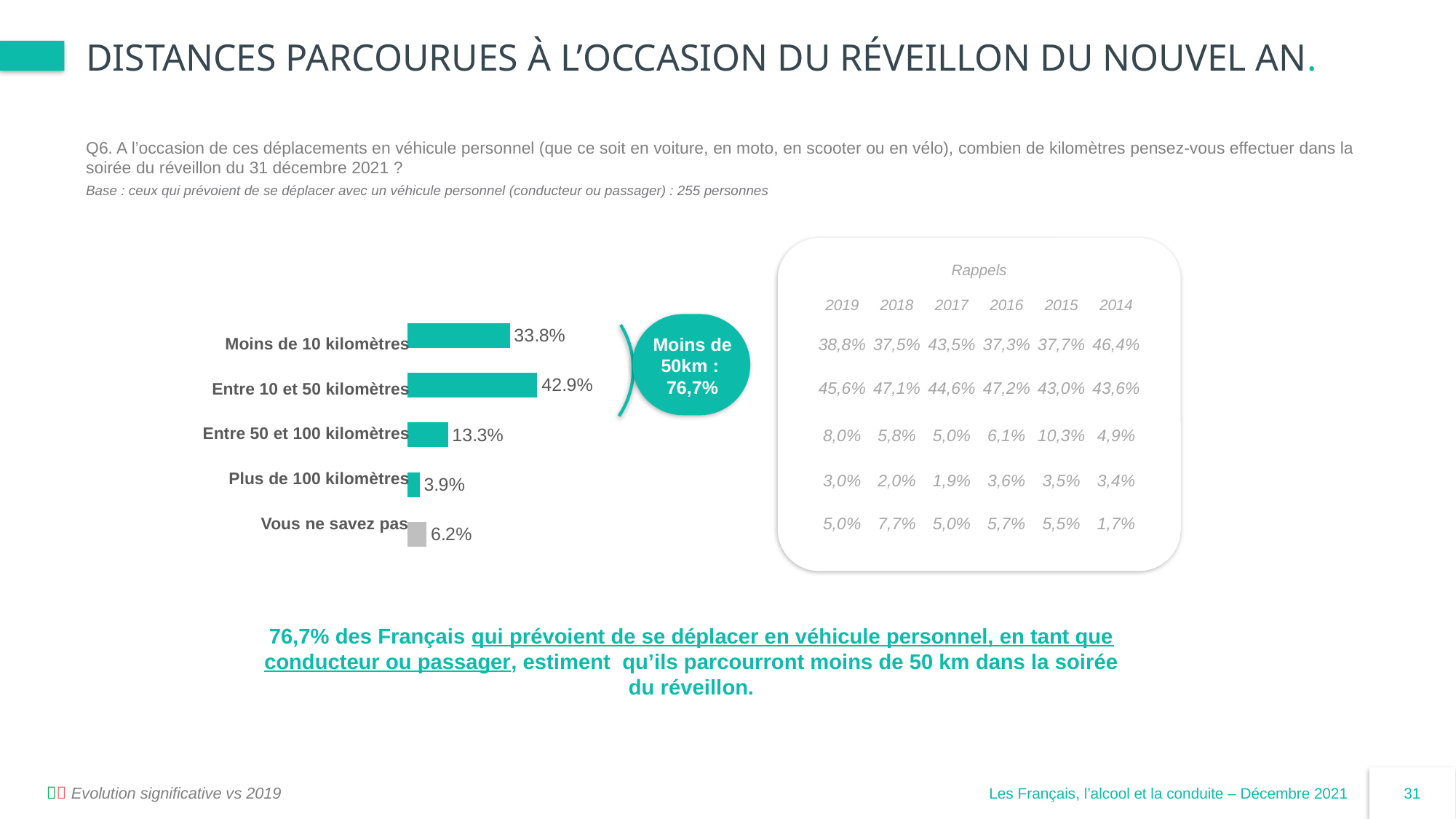
Which category has the highest value? Entre 10 et 50 kilomètres How many categories are shown in the bar chart? 5 What is the value for "Entre 10 et 50 kilomètres"? 42.9% Which bar is shown in grey rather than teal? Vous ne savez pas What is the value for "Plus de 100 kilomètres"? 3.9% Which category has the lowest value? Plus de 100 kilomètres What is the combined value for "Moins de 10 kilomètres" and "Entre 10 et 50 kilomètres" as shown in the circle? 76,7% What is the value for "Moins de 10 kilomètres"? 33.8% What is the value for "Vous ne savez pas"? 6.2% What kind of chart is shown on the slide? Bar chart What is the difference between "Entre 10 et 50 kilomètres" and "Moins de 10 kilomètres"? 9.1% Which is larger: "Entre 50 et 100 kilomètres" or "Vous ne savez pas"? Entre 50 et 100 kilomètres